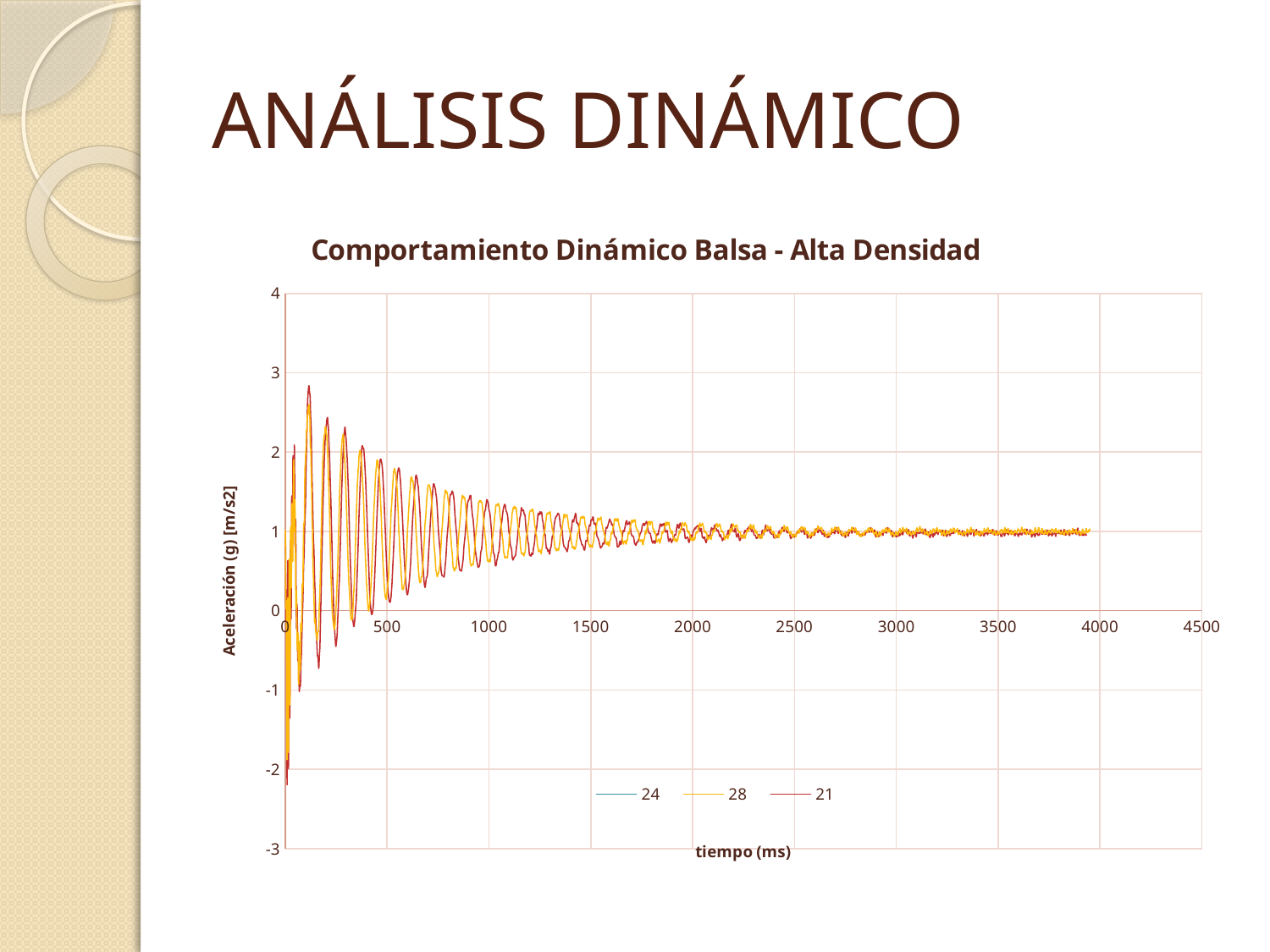
Is the highest peak reached by series 21 greater or less than 3? less Is the value of the series at 3500 ms greater or less than 2? less Is the value of series 28 at 1000 ms greater or less than 3? less What kind of chart is shown on the slide? line chart How does the amplitude of the oscillations change as time increases along the x axis? It decreases (the oscillations decay) What is the title of the chart? Comportamiento Dinámico Balsa - Alta Densidad What are the entries listed in the chart legend? 24, 28, 21 How many series does the legend list? 3